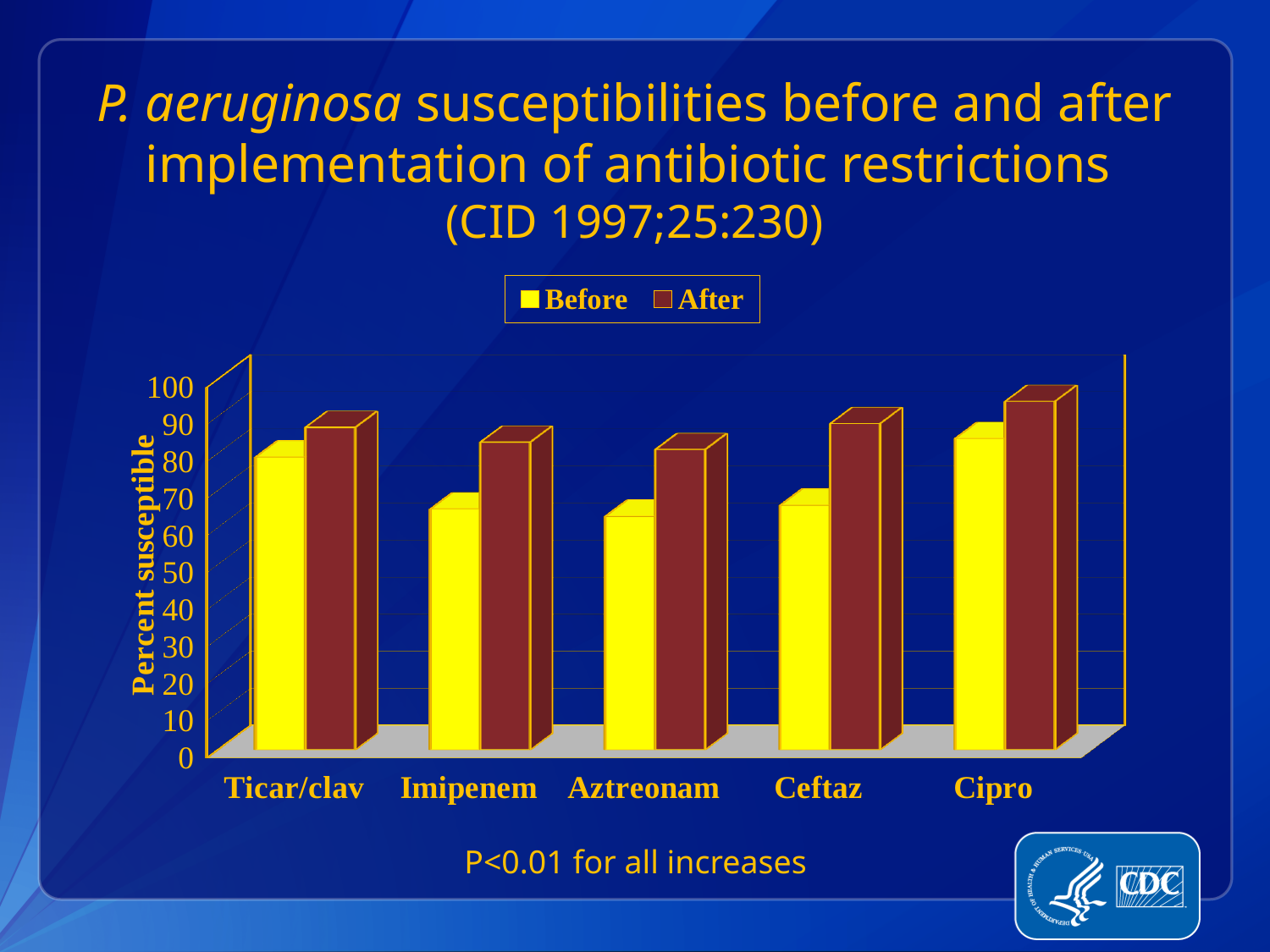
Is the Before value for Aztreonam greater or less than 70? less For Ceftaz, which is larger, the Before value or the After value? After Which antibiotic has the highest After value? Cipro Is the Before value for Ticar/clav greater or less than 70? greater How many series does the chart legend list? 2 What are the two series named in the chart legend? Before and After Which is larger, the Before value for Cipro or the Before value for Aztreonam? Cipro Is the After value for Cipro greater or less than 90? greater What kind of chart is shown on the slide? bar chart Which antibiotic has the highest Before value? Cipro How many antibiotics are shown on the x axis of the chart? 5 What is the title of the vertical axis of the chart? Percent susceptible